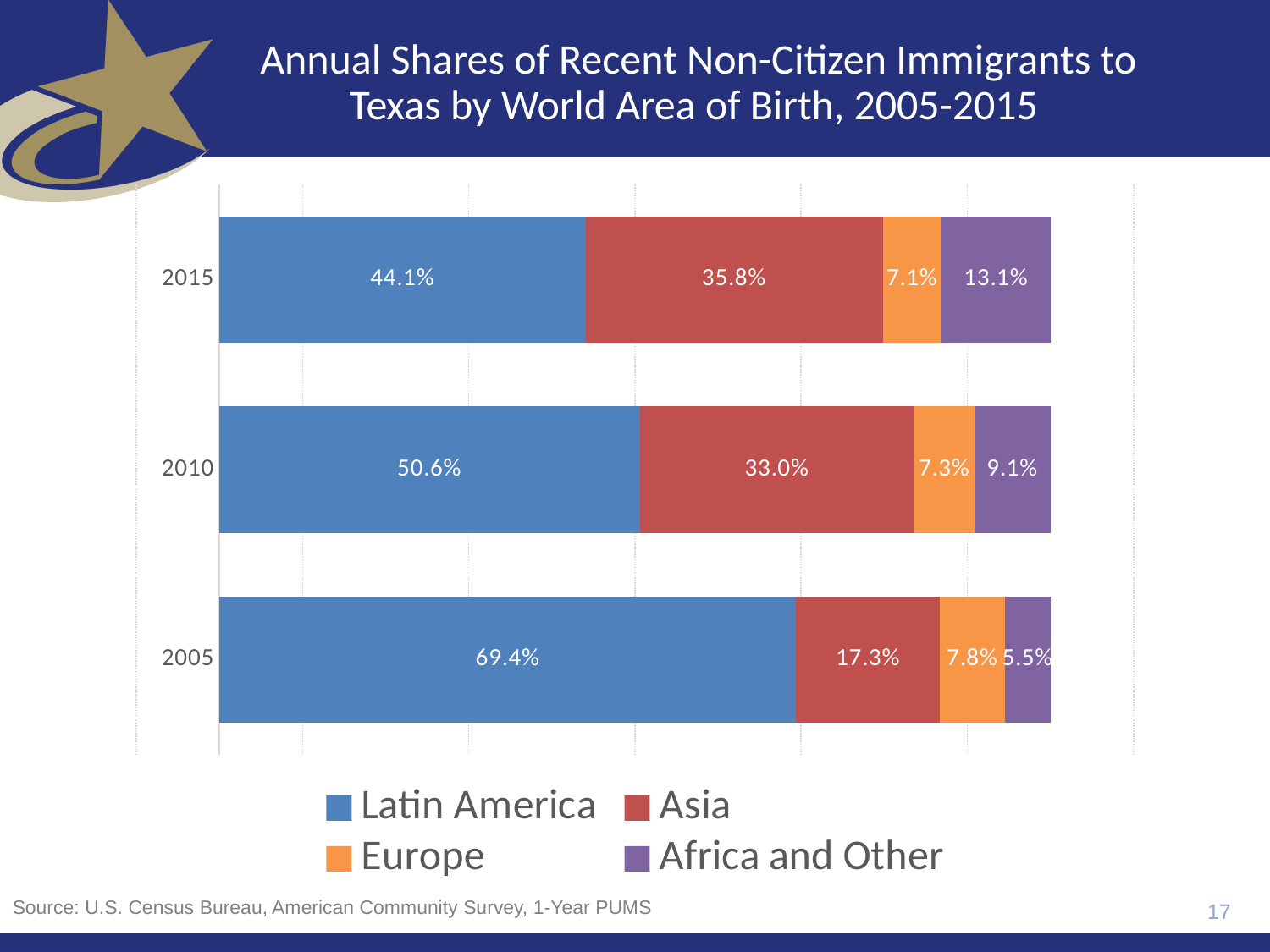
Does the Asia share rise or fall from 2005 to 2015? Rise What is the difference between the Latin America share in 2005 and in 2015? 25.3% What is the Latin America share for 2015? 44.1% What is the Africa and Other share for 2015? 13.1% How many series does the legend list? 4 What kind of chart is shown on the slide? Stacked bar chart In which year is the Latin America share highest? 2005 Which is larger in 2010: the Asia share or the Africa and Other share? Asia How many years are shown on the chart? 3 What is the Asia share for 2005? 17.3% In which year is the Africa and Other share lowest? 2005 What is the Europe share for 2010? 7.3%